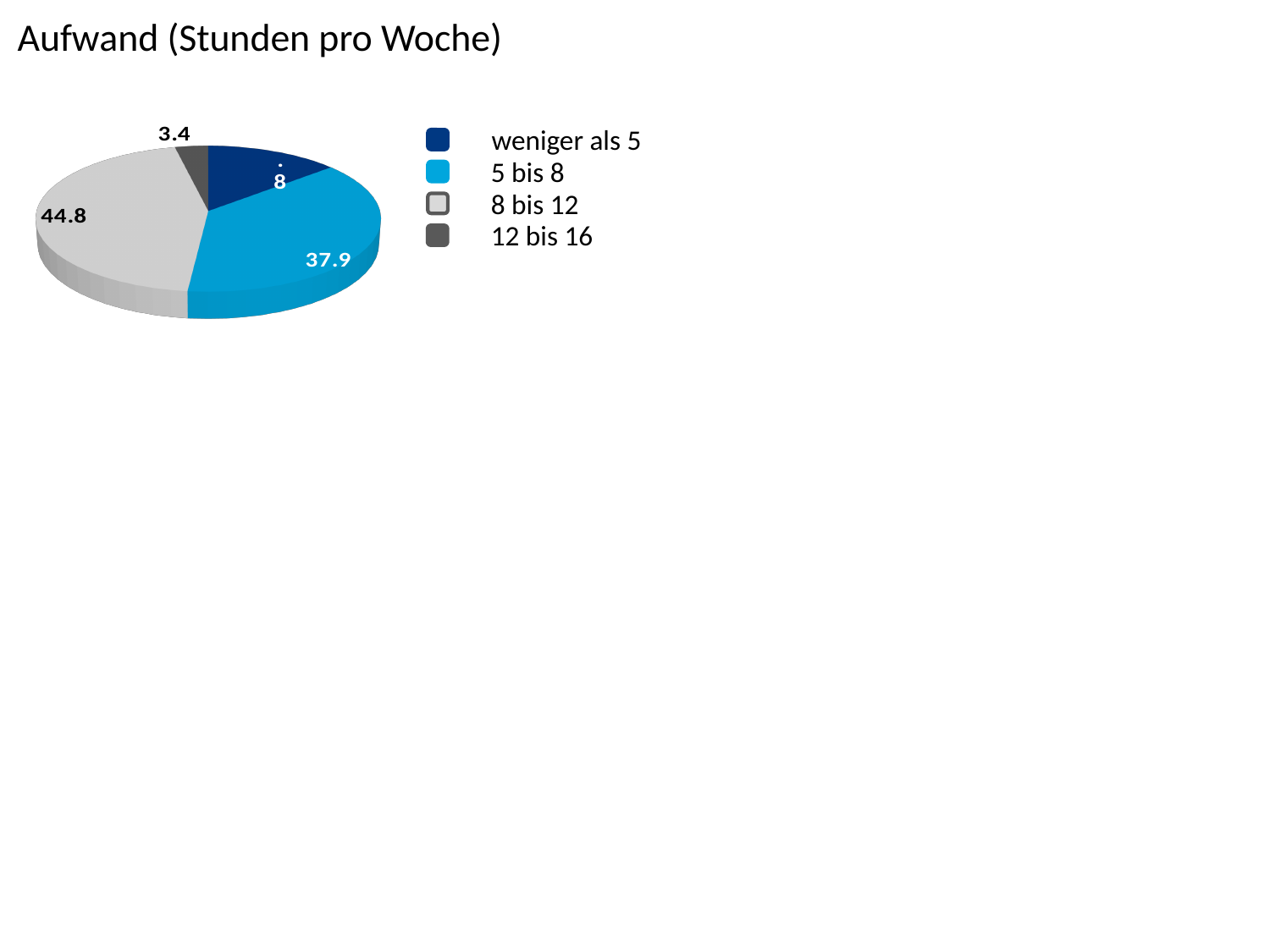
What is the difference between the values for "8 bis 12" and "5 bis 8"? 6.9 Which is larger, the slice for "5 bis 8" or the slice for "8 bis 12"? 8 bis 12 Which category has the smallest slice of the pie? 12 bis 16 How many categories does the pie chart have? 4 What is the value shown for the "12 bis 16" slice? 3.4 What is the value shown for the "8 bis 12" slice? 44.8 What is the title of the chart? Aufwand (Stunden pro Woche) What kind of chart is shown on the slide? pie chart Which category has the largest slice of the pie? 8 bis 12 What is the difference between the values for "5 bis 8" and "12 bis 16"? 34.5 What is the value shown for the "5 bis 8" slice? 37.9 Which category is shown in light grey in the legend? 8 bis 12